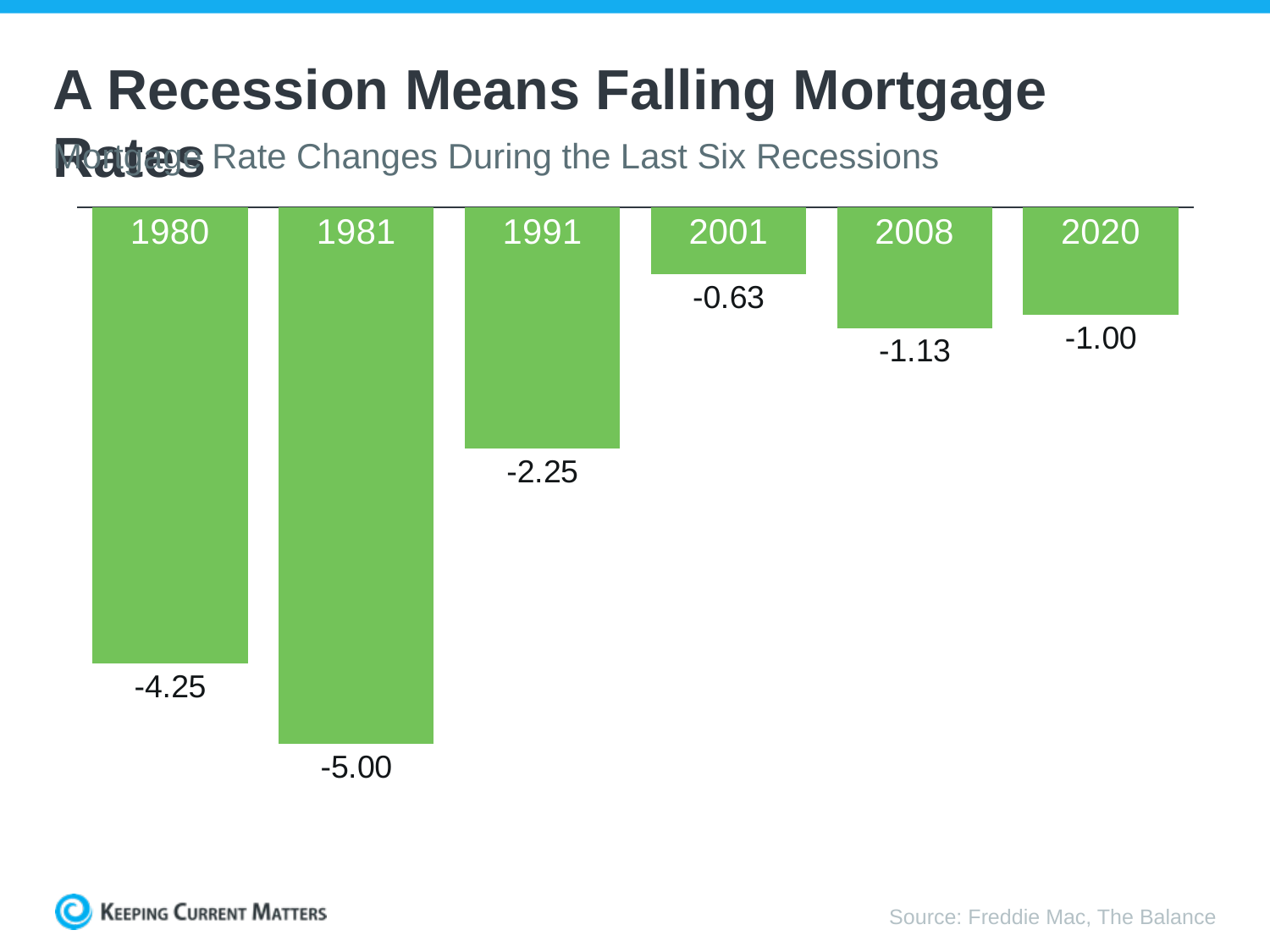
What is the title of the chart? Mortgage Rate Changes During the Last Six Recessions How many recessions are shown in the chart? 6 What type of chart is used on this slide? Bar chart What is the mortgage rate change shown for 2001? -0.63 Which recession year shows the largest drop in mortgage rates? 1981 What is the mortgage rate change shown for 2008? -1.13 Which recession year shows the smallest drop in mortgage rates? 2001 What is the mortgage rate change shown for 1981? -5.00 How much larger is the rate drop in 1981 than in 1980? 0.75 What is the difference between the rate changes for 1991 and 2001? 1.62 What is the mortgage rate change shown for 2020? -1.00 Which year had a bigger drop in mortgage rates, 1980 or 1991? 1980